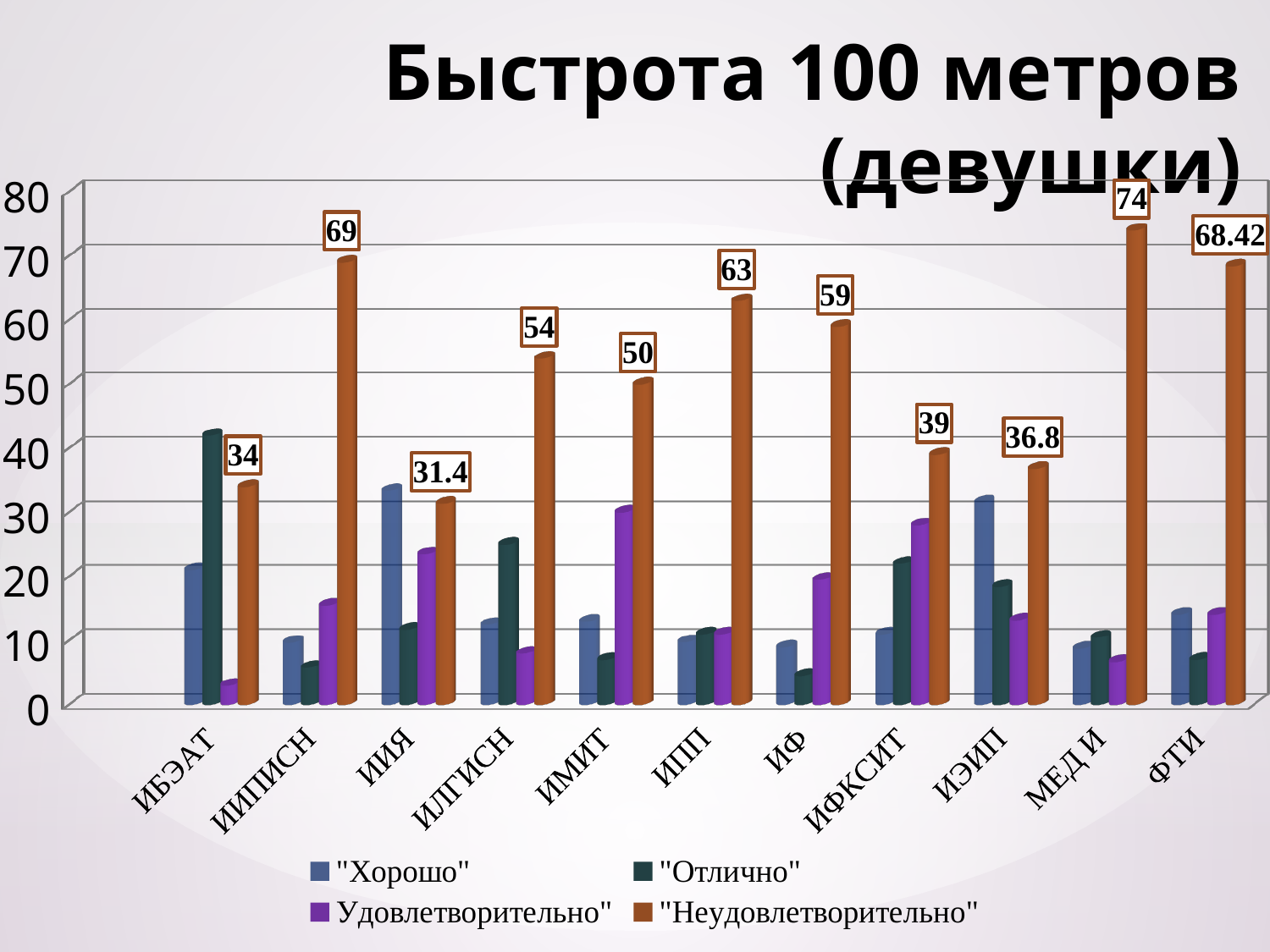
How many series does the legend list? 4 Which category has the highest "Неудовлетворительно" value? МЕД И What is the value of "Неудовлетворительно" for ФТИ? 68.42 How many categories are shown on the x axis? 11 What is the value of "Неудовлетворительно" for МЕДИ? 74 Is the "Удовлетворительно" value for ИБЭАТ greater or less than 10? less What is the difference between the "Неудовлетворительно" values for ИИПИСН and ИБЭАТ? 35 What type of chart is shown on the slide? bar chart Which has a larger "Неудовлетворительно" value, ИПП or ИФ? ИПП What is the value of "Неудовлетворительно" for ИИЯ? 31.4 Which category has the lowest "Неудовлетворительно" value? ИИЯ Is the "Отлично" value for ИБЭАТ greater or less than 40? greater